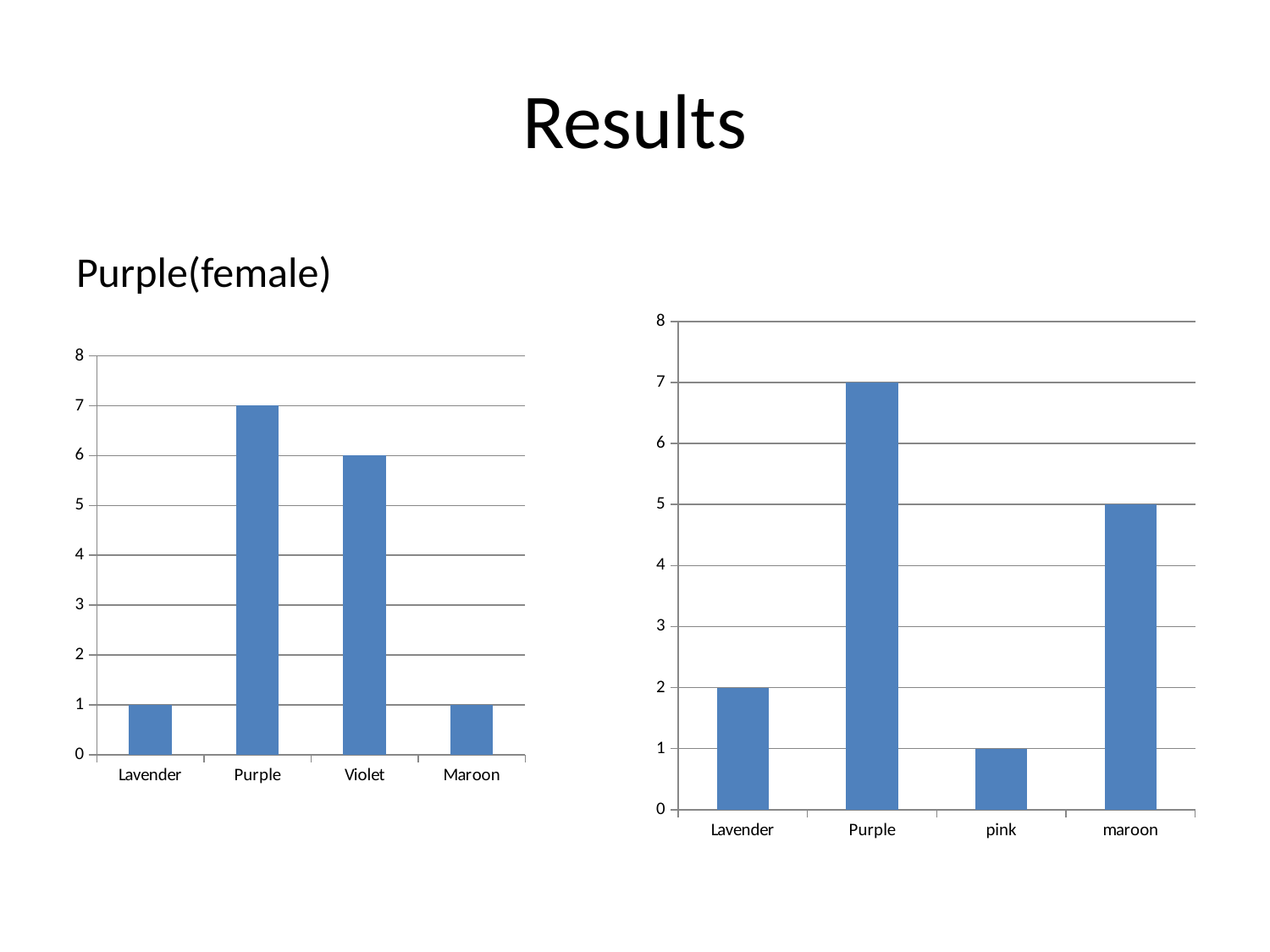
On the left chart, which category has the highest value? Purple On the right chart, what is the difference between the values for Purple and pink? 6 On the left chart, what is the value for Violet? 6 On the right chart, what is the value for Lavender? 2 On the right chart, which is larger, the value for Purple or the value for maroon? Purple On the right chart, what is the value for maroon? 5 What text label appears above the left chart? Purple(female) On the right chart, which category has the lowest value? pink What kind of chart is the right chart? Bar chart On the left chart, what is the value for Purple? 7 On the left chart, what is the difference between the values for Purple and Lavender? 6 On the left chart, how many categories are shown on the x axis? 4